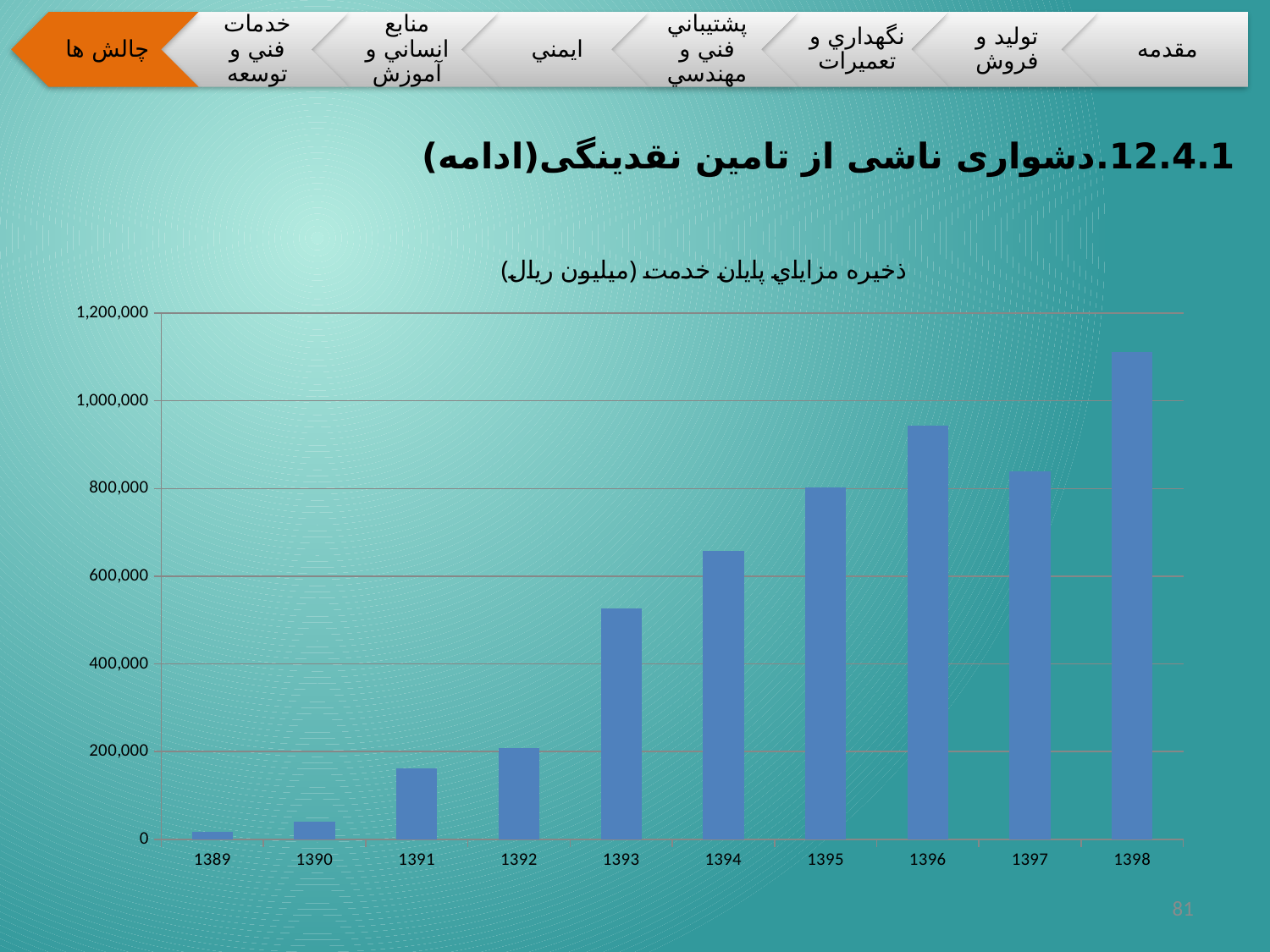
Is the value for 1393 greater or less than 400,000? greater How many years are shown on the x axis of the chart? 10 Which year has the lowest bar in the chart? 1389 Is the value for 1398 greater or less than 1,000,000? greater Is the value for 1392 greater or less than 400,000? less Which year has the larger value, 1396 or 1397? 1396 What is the title of the chart? ذخيره مزاياي پايان خدمت (ميليون ريال) Which year has the highest bar in the chart? 1398 What kind of chart is shown on the slide? bar chart Do the values generally rise or fall from 1389 to 1398? rise